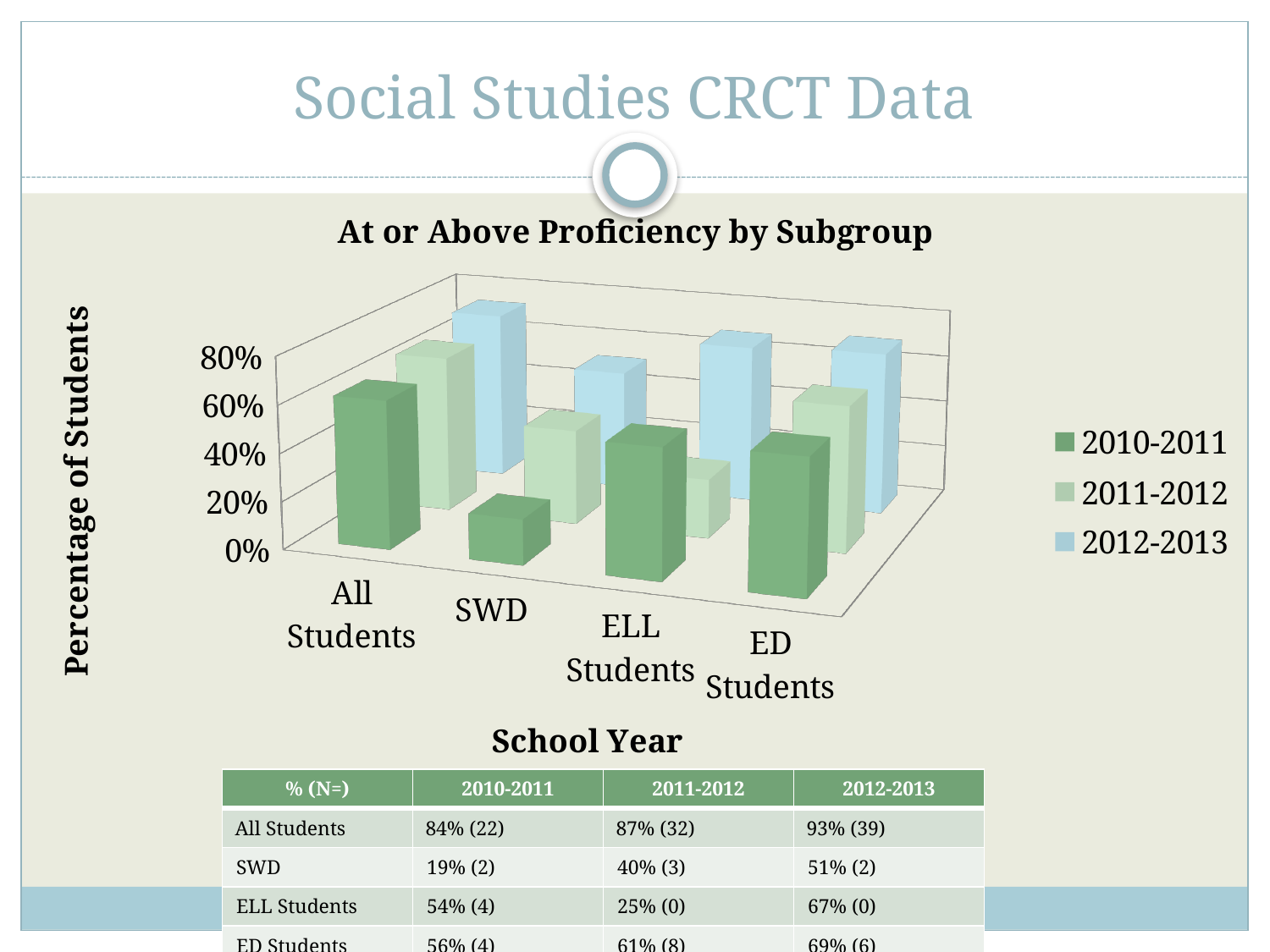
What percentage of ELL Students were at or above proficiency in 2011-2012? 25% What kind of chart is shown on the slide? bar chart By how many percentage points did the All Students value increase from 2010-2011 to 2012-2013? 9% Is the value for ED Students in 2012-2013 greater or less than 60%? greater Did the All Students percentage rise or fall from 2010-2011 through 2012-2013? rise In 2011-2012, which was higher: SWD or ELL Students? SWD What percentage of All Students were at or above proficiency in 2012-2013? 93% How many subgroups are shown on the x axis of the chart? 4 What percentage of SWD students were at or above proficiency in 2010-2011? 19% Which subgroup had the highest percentage at or above proficiency in 2010-2011? All Students Which subgroup had the lowest percentage at or above proficiency in 2011-2012? ELL Students How many school years does the legend list? 3